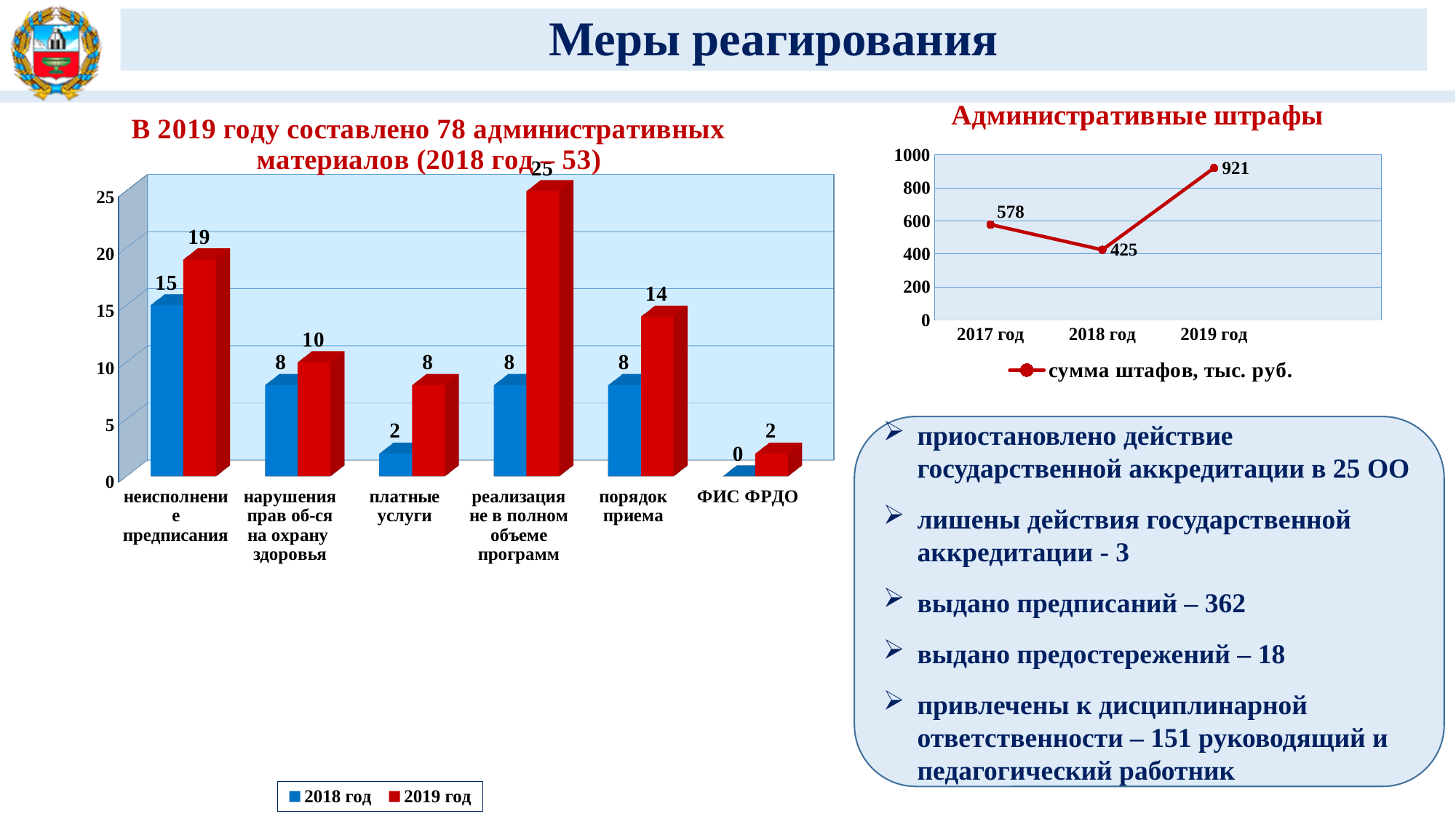
In the 'Административные штрафы' chart, what is the difference between the values for 2019 год and 2017 год? 343 In the bar chart on the left, what is the value for 2018 год for 'неисполнение предписания'? 15 In the bar chart on the left, what is the value for 2019 год for 'реализация не в полном объеме программ'? 25 In the bar chart on the left, what is the difference between the 2019 год and 2018 год values for 'платные услуги'? 6 In the bar chart on the left, which category has the highest value for 2019 год? реализация не в полном объеме программ What kind of chart is the 'Административные штрафы' chart? line chart How many categories are shown in the bar chart on the left? 6 In the 'Административные штрафы' chart, which year has the highest value? 2019 год In the bar chart on the left, which category has the lowest value for 2018 год? ФИС ФРДО In the 'Административные штрафы' chart, what is the value for 2018 год? 425 In the bar chart on the left, which is larger for 'порядок приема': the 2018 год value or the 2019 год value? 2019 год How many series does the legend of the bar chart on the left list? 2